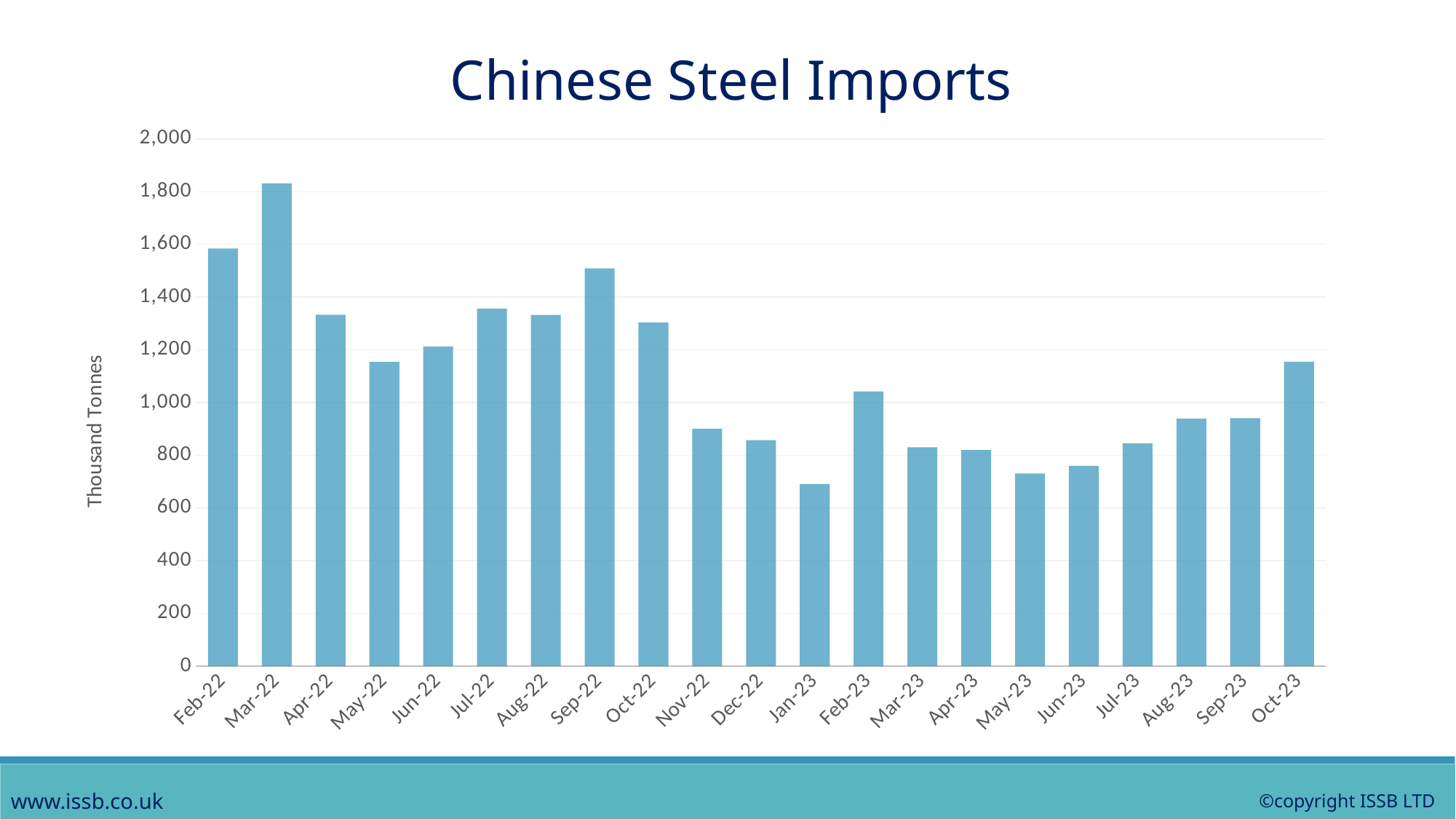
Is the value for Oct-23 greater or less than 1,000? greater Is the value for Feb-22 greater or less than 1,400? greater What is the title of the chart? Chinese Steel Imports Which month has the lowest value? Jan-23 What kind of chart is shown on the slide? Bar chart Is the value for Jan-23 greater or less than 800? less Do the values rise or fall from Feb-23 to May-23? fall Which is larger, the value for Mar-22 or the value for Sep-22? Mar-22 Which month has the highest value? Mar-22 How many months are plotted on the chart? 21 What is the label on the vertical axis? Thousand Tonnes